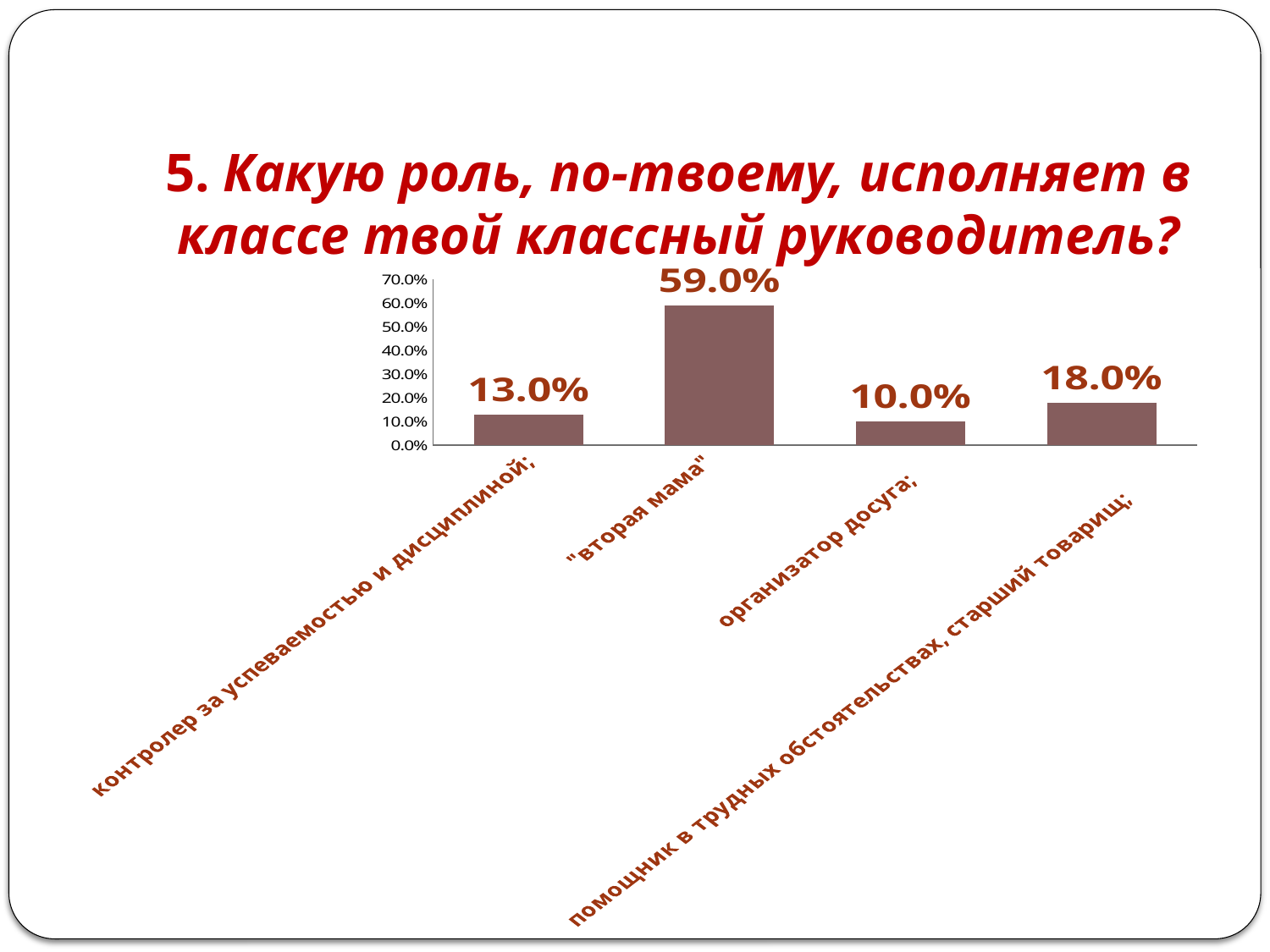
What is the value for "контролер за успеваемостью и дисциплиной"? 13.0% Is the value for "вторая мама" greater or less than 50.0%? greater Which is larger: the value for "помощник в трудных обстоятельствах, старший товарищ" or for "контролер за успеваемостью и дисциплиной"? помощник в трудных обстоятельствах, старший товарищ What is the value for "вторая мама"? 59.0% How many categories are shown in the chart? 4 What is the value for "организатор досуга"? 10.0% What kind of chart is shown on the slide? bar chart Which category has the highest value? "вторая мама" What is the value for "помощник в трудных обстоятельствах, старший товарищ"? 18.0% Which category has the lowest value? организатор досуга What is the difference between the values for "вторая мама" and "помощник в трудных обстоятельствах, старший товарищ"? 41.0% What is the difference between the values for "контролер за успеваемостью и дисциплиной" and "организатор досуга"? 3.0%